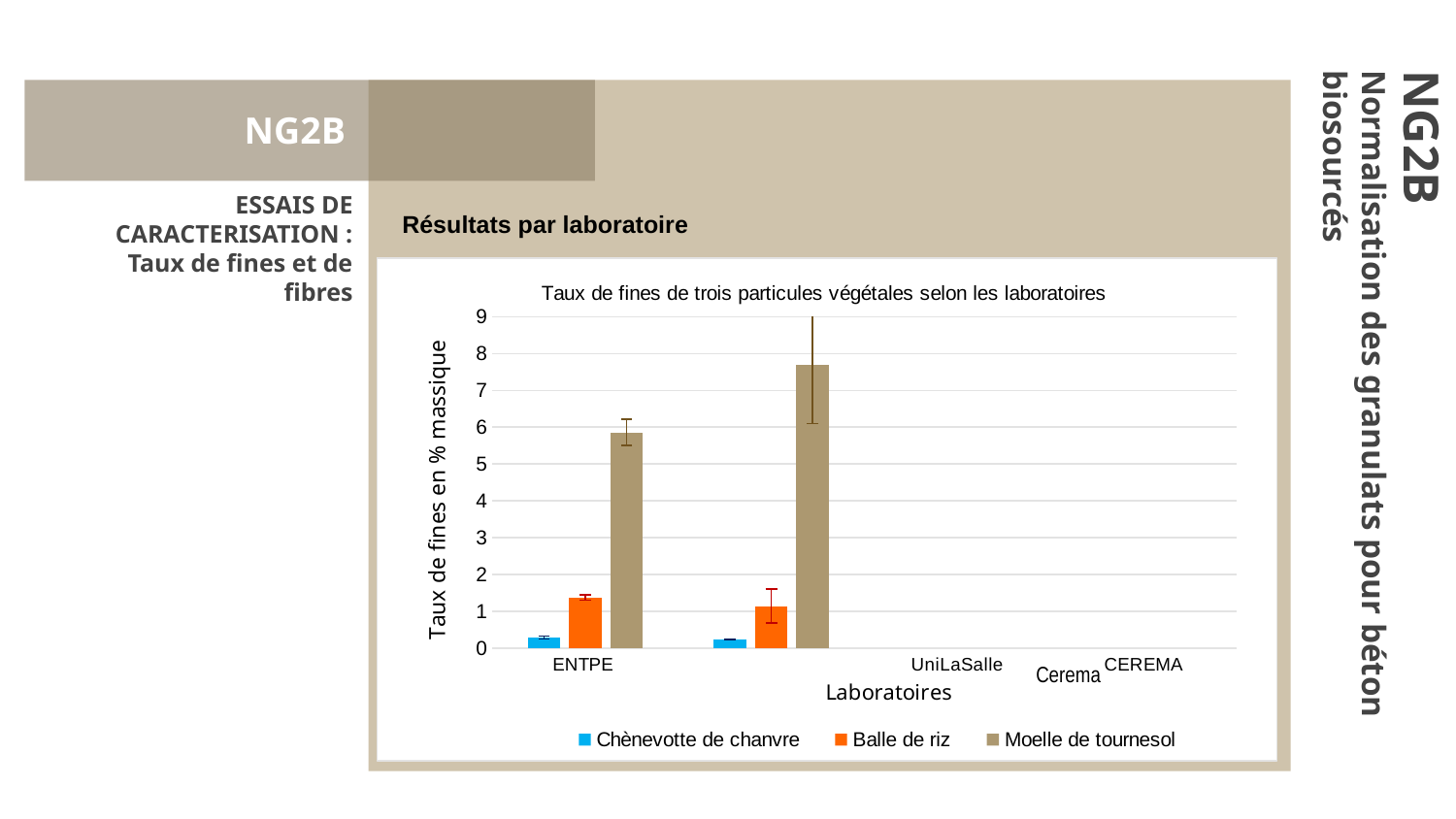
What is the title of the chart? Taux de fines de trois particules végétales selon les laboratoires How many series does the chart legend list? 3 At ENTPE, which is larger: Balle de riz or Chènevotte de chanvre? Balle de riz What kind of chart is shown on the slide? bar chart What is the label of the vertical axis? Taux de fines en % massique Is the value for Balle de riz at ENTPE greater or less than 2? less For ENTPE, which series has the lowest value? Chènevotte de chanvre Is the Moelle de tournesol bar taller for ENTPE or for the second group of bars? the second group of bars For ENTPE, which series has the highest value? Moelle de tournesol Is the Moelle de tournesol bar in the second group of bars greater or less than 7? greater Is the value for Moelle de tournesol at ENTPE greater or less than 5? greater